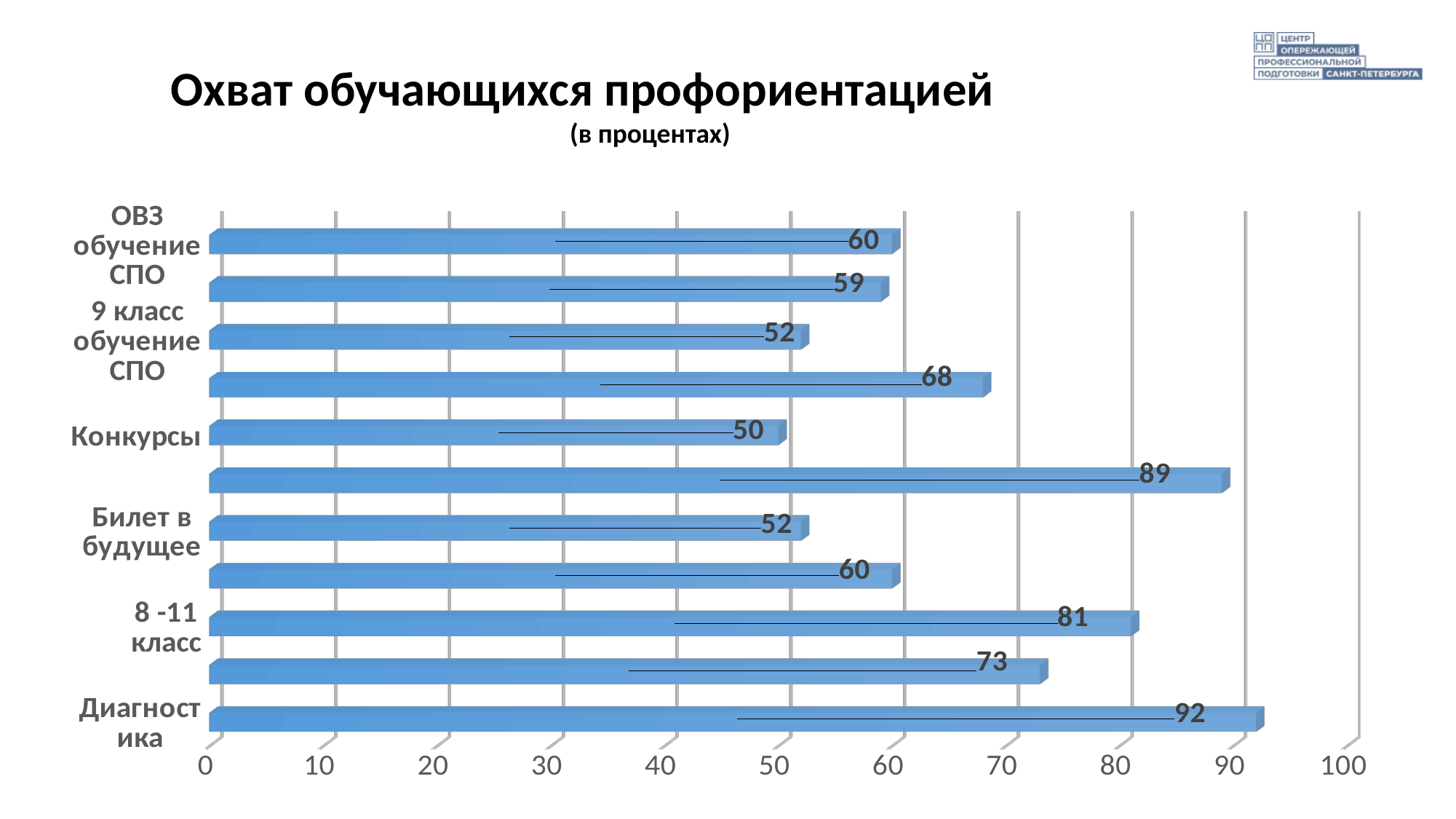
What is the title of the chart? Охват обучающихся профориентацией (в процентах) Which category has the highest value? Диагностика What is the value for Конкурсы? 50 What is the value for Билет в будущее? 52 What is the value for 8 -11 класс? 81 What is the difference between the values for Диагностика and 8 -11 класс? 11 What is the value for Диагностика? 92 How many bars are plotted in the chart? 11 What is the value for ОВЗ обучение СПО? 60 Which is larger, the value for 9 класс обучение СПО or the value for ОВЗ обучение СПО? ОВЗ обучение СПО Which category has the lowest value? Конкурсы What type of chart is shown on the slide? bar chart